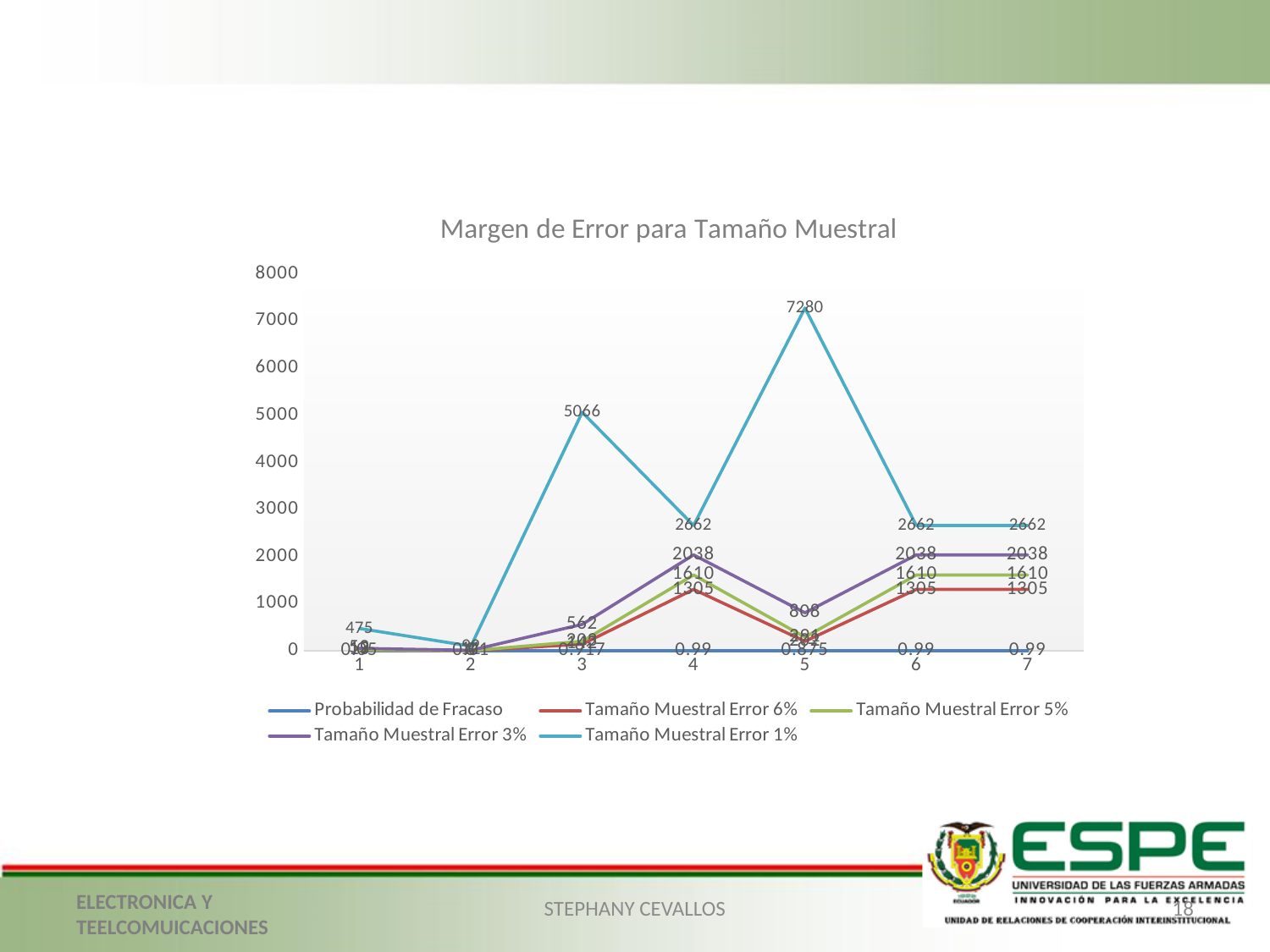
At which x-axis point does Tamaño Muestral Error 1% reach its highest value? 5 What kind of chart is shown on the slide? line chart How many series does the legend list? 5 What is the value of Tamaño Muestral Error 3% at point 4? 2038 What is the title of the chart? Margen de Error para Tamaño Muestral What is the value of Tamaño Muestral Error 6% at point 7? 1305 What is the value of Tamaño Muestral Error 1% at point 3? 5066 For Tamaño Muestral Error 1%, which is larger: the value at point 5 or the value at point 3? point 5 What is the value of Tamaño Muestral Error 1% at point 5? 7280 Is the value of Tamaño Muestral Error 1% at point 4 greater or less than 2000? greater How many points are plotted along the x axis? 7 What is the difference between the Tamaño Muestral Error 1% values at point 5 and point 3? 2214